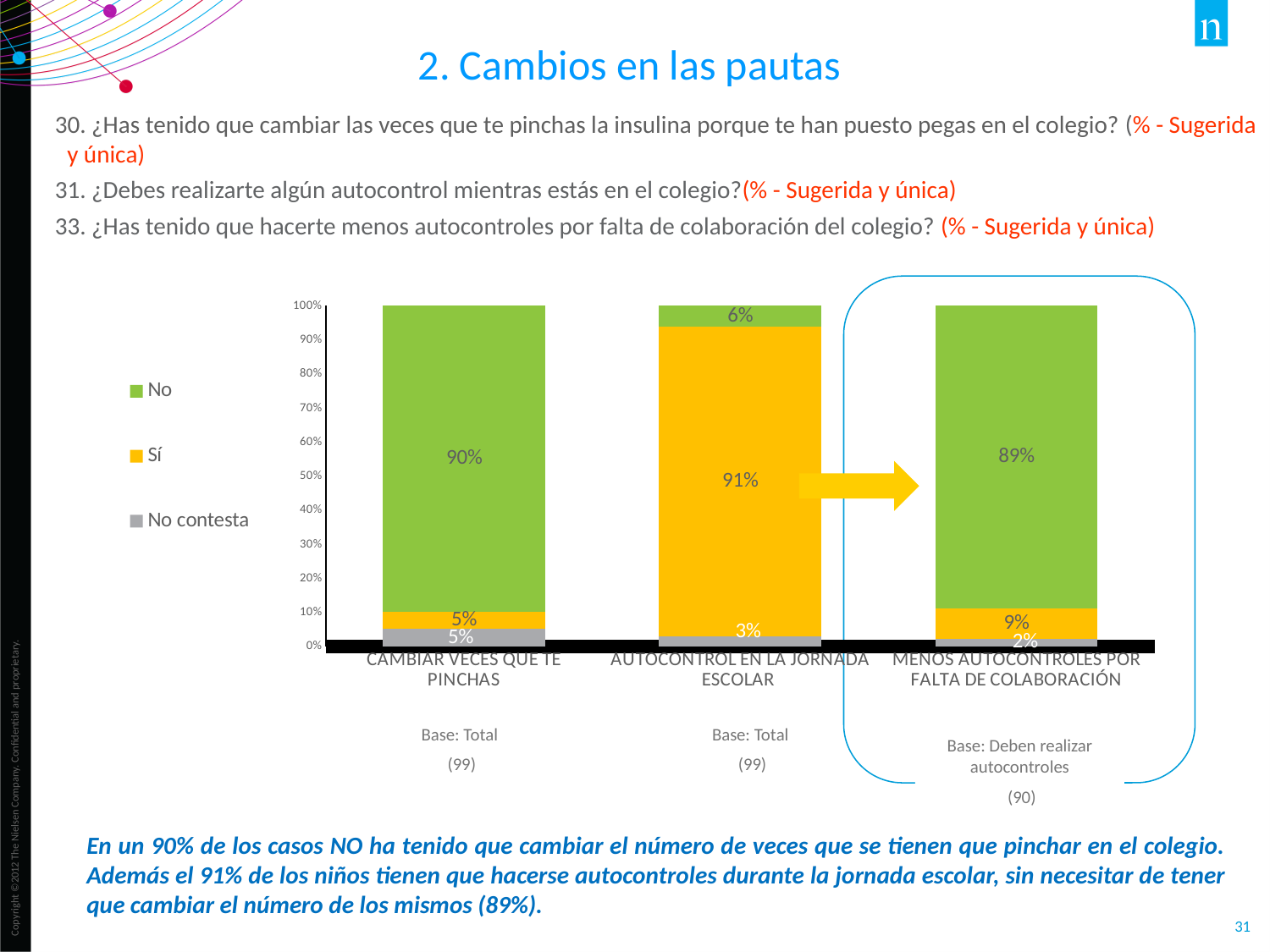
What is the difference between the "Sí" values for "MENOS AUTOCONTROLES POR FALTA DE COLABORACIÓN" and "CAMBIAR VECES QUE TE PINCHAS"? 4% What is the "No contesta" value for "AUTOCONTROL EN LA JORNADA ESCOLAR"? 3% Which category has the highest "Sí" percentage? AUTOCONTROL EN LA JORNADA ESCOLAR What kind of chart is shown on the slide? Stacked bar chart Which is larger: the "No" value for "CAMBIAR VECES QUE TE PINCHAS" or the "No" value for "MENOS AUTOCONTROLES POR FALTA DE COLABORACIÓN"? CAMBIAR VECES QUE TE PINCHAS How many categories are shown on the x axis of the chart? 3 What percentage answered "Sí" for "AUTOCONTROL EN LA JORNADA ESCOLAR"? 91% Which colour represents "Sí" in the chart? Yellow How many series does the legend list? 3 Which category has the lowest "No" percentage? AUTOCONTROL EN LA JORNADA ESCOLAR What percentage answered "No" for "CAMBIAR VECES QUE TE PINCHAS"? 90% What percentage answered "No" for "MENOS AUTOCONTROLES POR FALTA DE COLABORACIÓN"? 89%